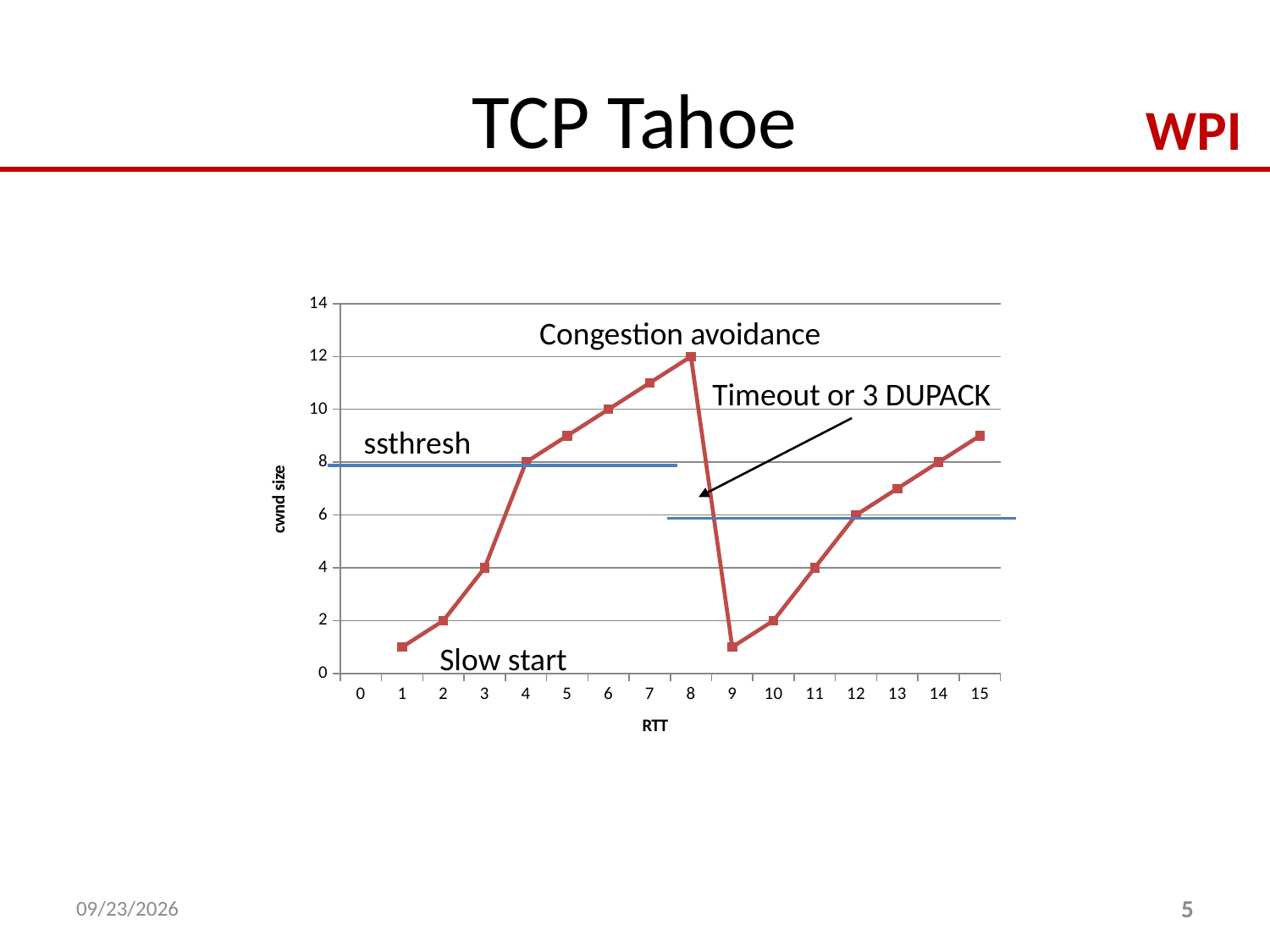
Is the cwnd size at RTT 9 greater or less than 2? less What kind of chart is shown on the slide? line chart What is the cwnd size at RTT 8? 12 What is the label of the x axis? RTT What is the cwnd size at RTT 12? 6 What is the cwnd size at RTT 4? 8 At which RTT is the cwnd size highest? 8 What is the difference between the cwnd size at RTT 8 and at RTT 4? 4 Which has a larger cwnd size, RTT 8 or RTT 15? RTT 8 What is the cwnd size at RTT 6? 10 Is the cwnd size at RTT 7 greater or less than 10? greater Does the cwnd size rise or fall from RTT 1 to RTT 8? rise